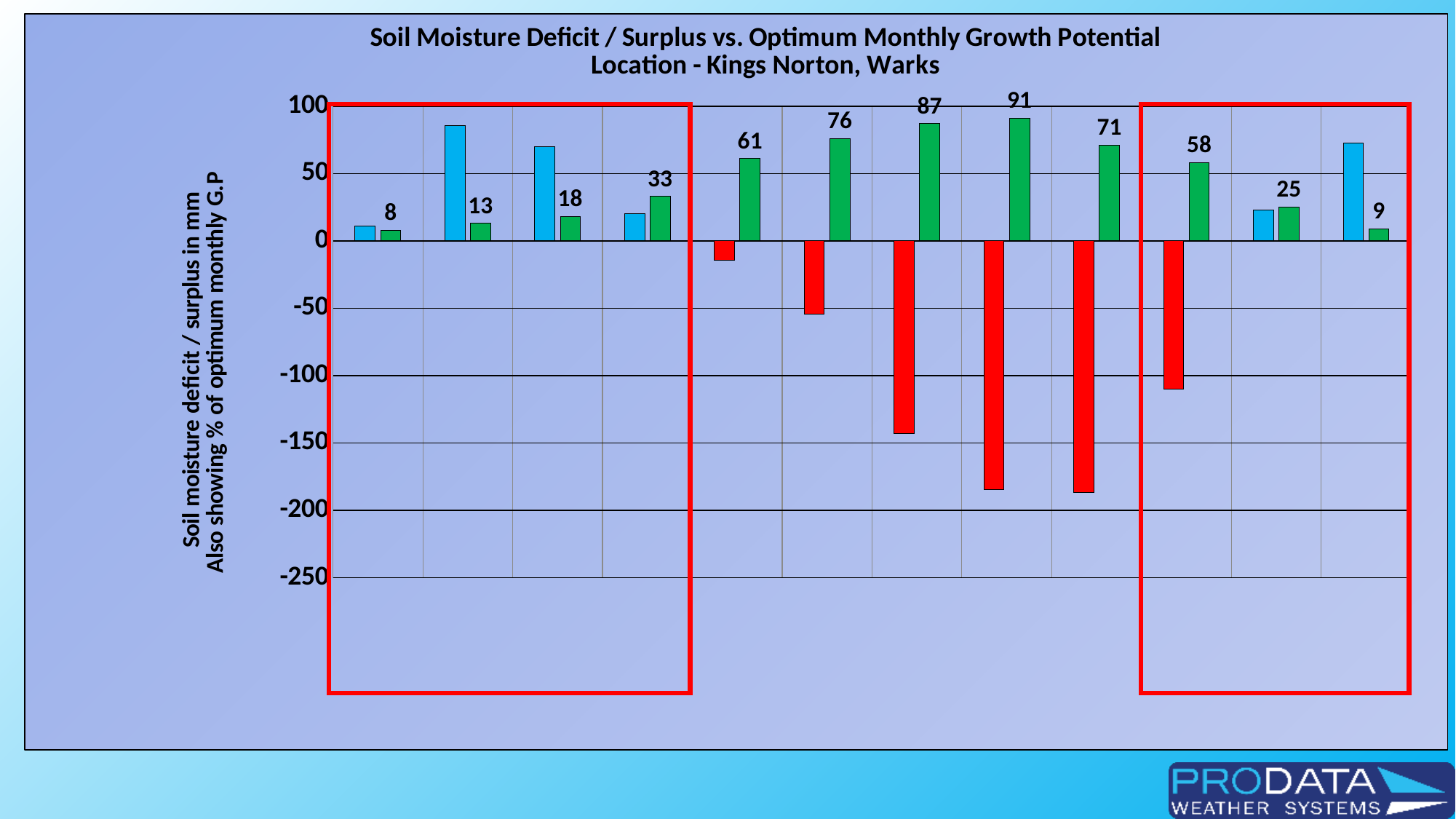
Is the red bar in the eighth group from the left greater or less than -150? less What is the difference between the highest green bar label (91) and the lowest green bar label (8)? 83 What is the value labelled on the green bar in the fifth group from the left? 61 Do the green bar labels rise or fall from the first group to the eighth group? rise What is the value labelled on the green bar in the first group from the left? 8 Which is larger: the green bar label in the sixth group (76) or the green bar label in the seventh group (87)? 87 What is the title of the chart? Soil Moisture Deficit / Surplus vs. Optimum Monthly Growth Potential Location - Kings Norton, Warks Is the blue bar in the second group from the left greater or less than 50? greater What is the lowest value labelled on a green bar? 8 What type of chart is shown on the slide? bar chart How many groups of bars are plotted along the x axis? 12 What is the highest value labelled on a green bar? 91